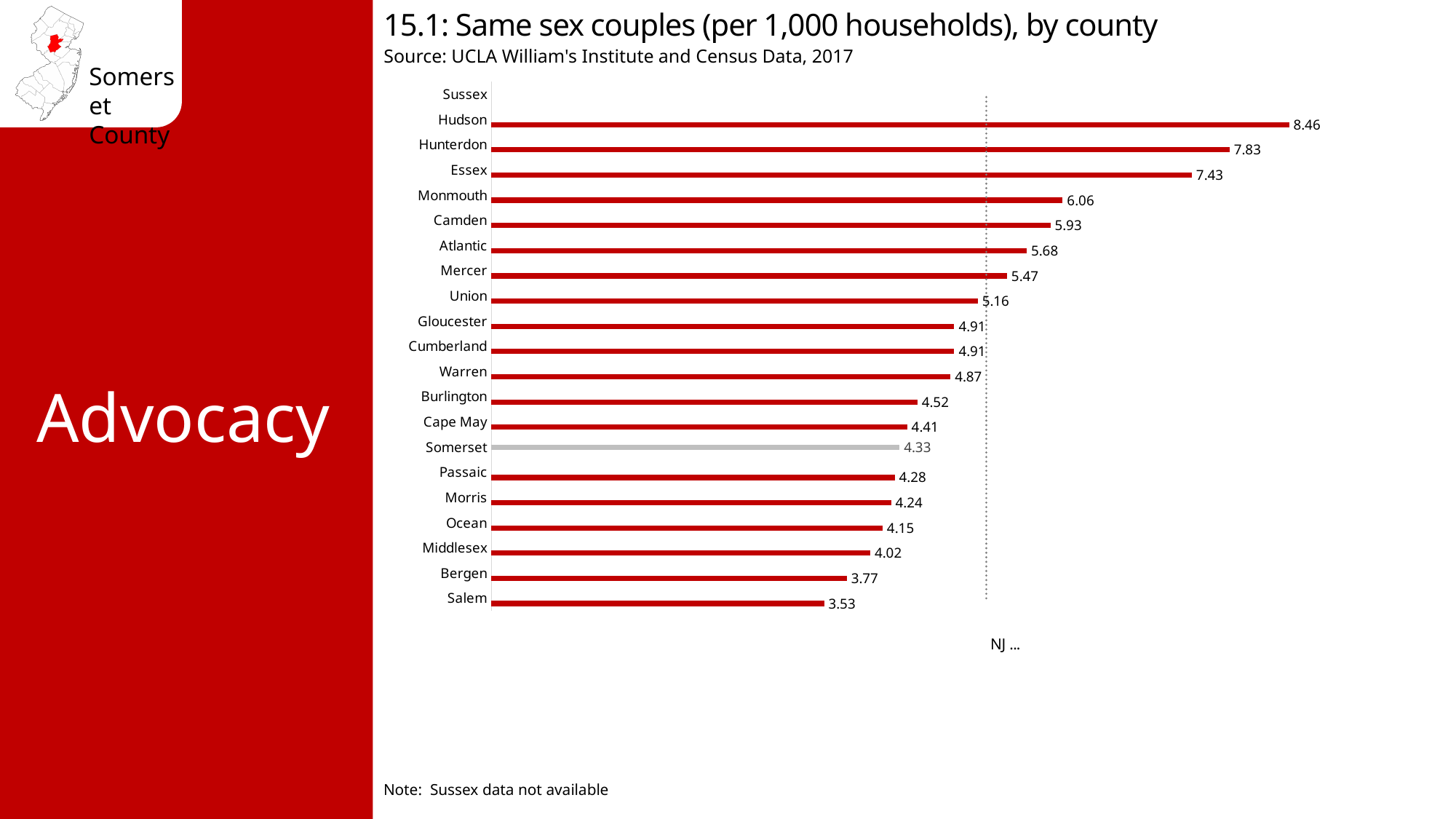
Which has a larger value, Monmouth or Camden? Monmouth What is the value for Hudson? 8.46 Which county has the highest value shown? Hudson What is the difference between the values for Somerset and Passaic? 0.05 Which county has no data shown on the chart? Sussex Which has a larger value, Bergen or Middlesex? Middlesex Which county has the lowest value shown? Salem What kind of chart is this? Bar chart What is the value for Salem? 3.53 What is the difference between the values for Hudson and Hunterdon? 0.63 What is the value for Somerset? 4.33 How many counties are listed on the chart? 21